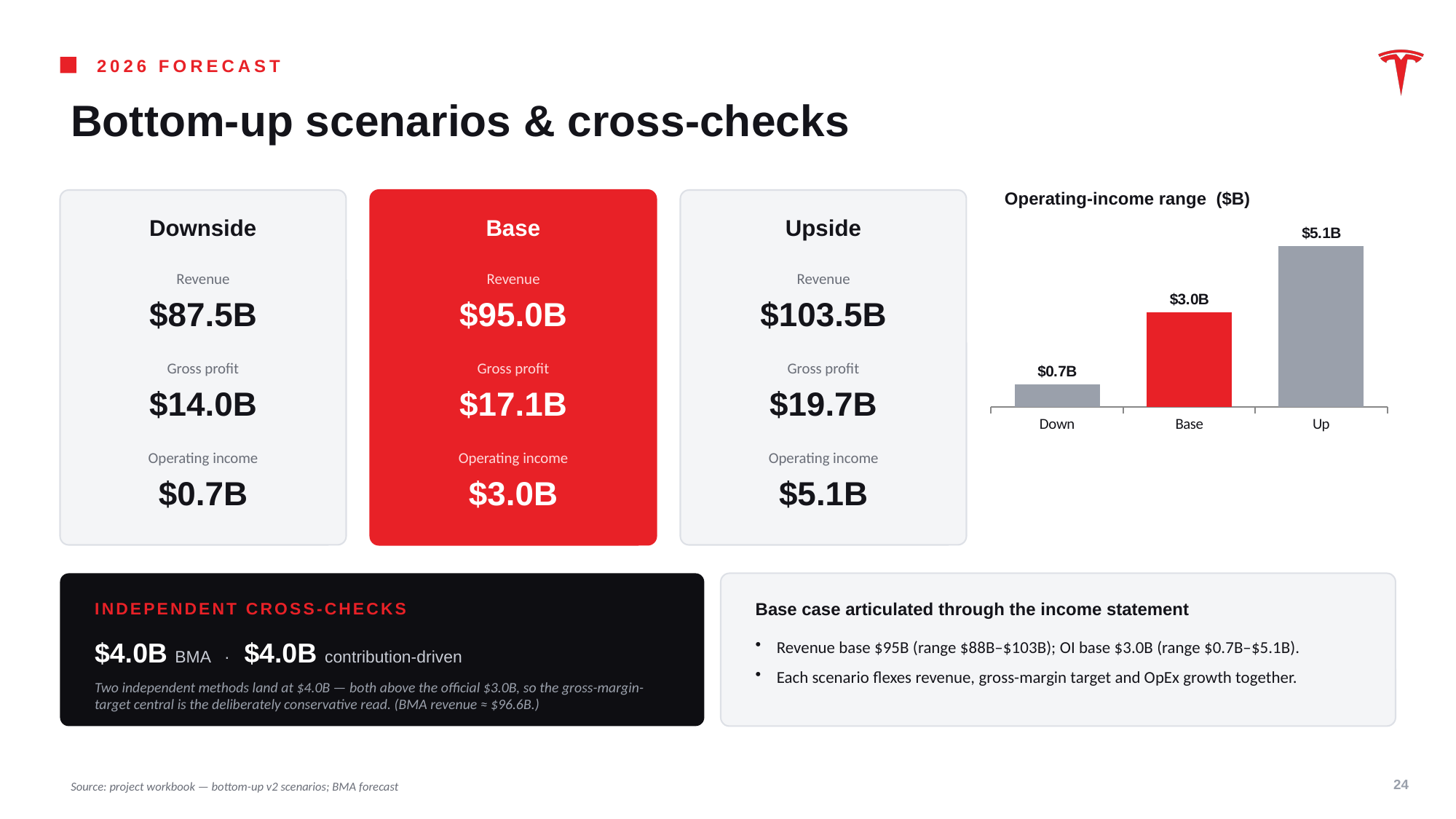
What is the title of the chart on the slide? Operating-income range ($B) What is the value for Base in the Operating-income range chart? $3.0B In the Operating-income range chart, which is larger: Base or Up? Up What is the difference between the Base and Down values in the Operating-income range chart? $2.3B Which category has the highest value in the Operating-income range chart? Up Which category has the lowest value in the Operating-income range chart? Down How many categories are shown in the Operating-income range chart? 3 What is the difference between the Up and Down values in the Operating-income range chart? $4.4B What kind of chart is the Operating-income range chart? Bar chart Do the values in the Operating-income range chart rise or fall from Down to Up? Rise What is the value for Down in the Operating-income range chart? $0.7B What is the value for Up in the Operating-income range chart? $5.1B